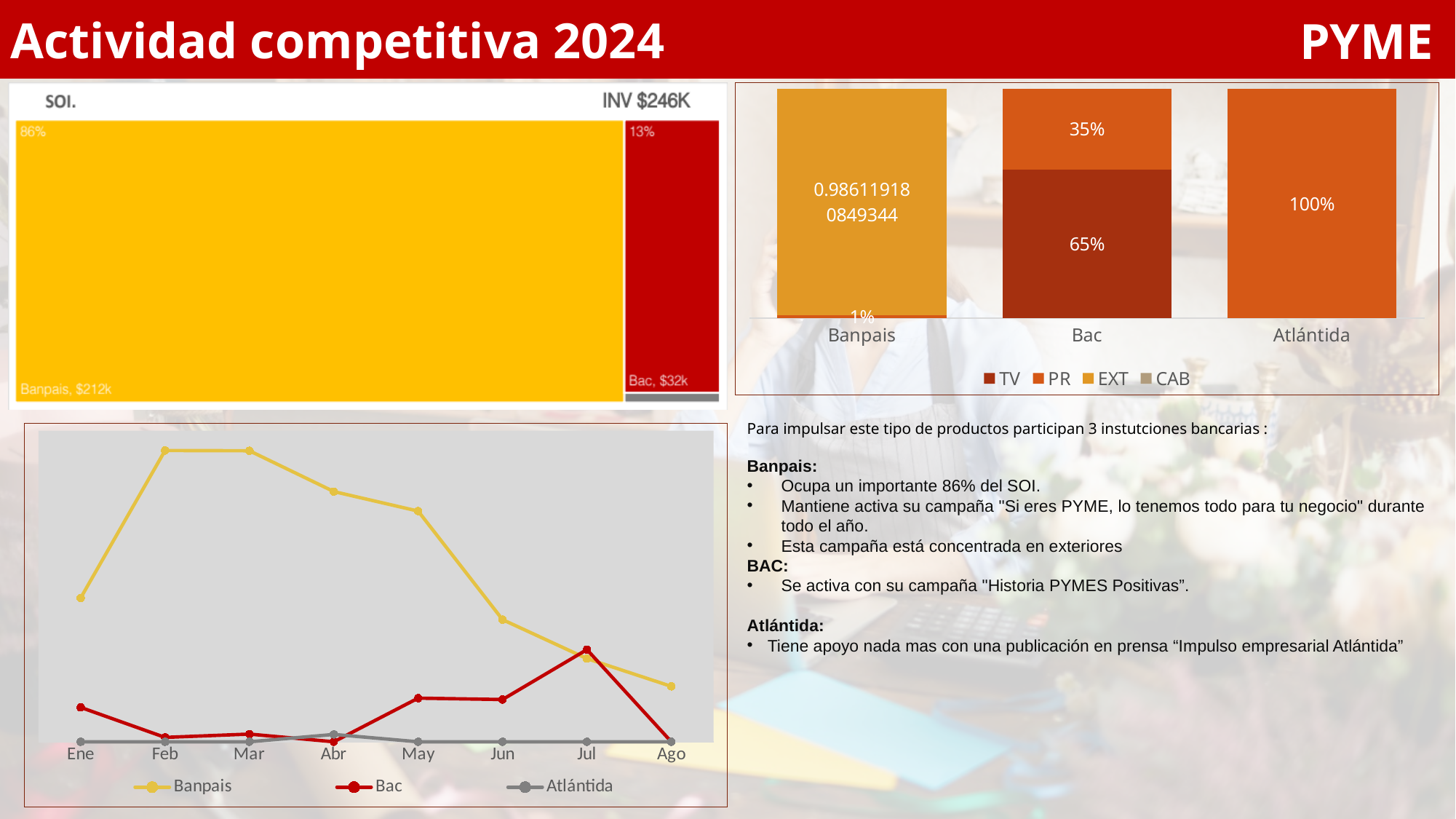
In the stacked bar chart at the top right, what percentage is shown for Atlántida? 100% In the line chart at the bottom left, which series is higher in Feb, Banpais or Bac? Banpais How many series does the legend of the stacked bar chart at the top right list? 4 In the stacked bar chart at the top right, what percentage of Bac's activity is TV? 65% How many months are plotted on the x axis of the line chart at the bottom left? 8 What kind of chart is the one at the bottom left showing months Ene to Ago? Line chart In the line chart at the bottom left, in which month does Bac reach its highest value? Jul In the SOI treemap at the top left, what is the difference in percentage points between Banpais's share and Bac's share? 73% In the SOI treemap at the top left, what share of the SOI does Banpais hold? 86% In the SOI treemap at the top left, what investment amount is shown for Bac? $32k In the stacked bar chart at the top right, what percentage of Bac's activity is PR? 35% In the SOI treemap at the top left, what total investment (INV) is shown? $246K